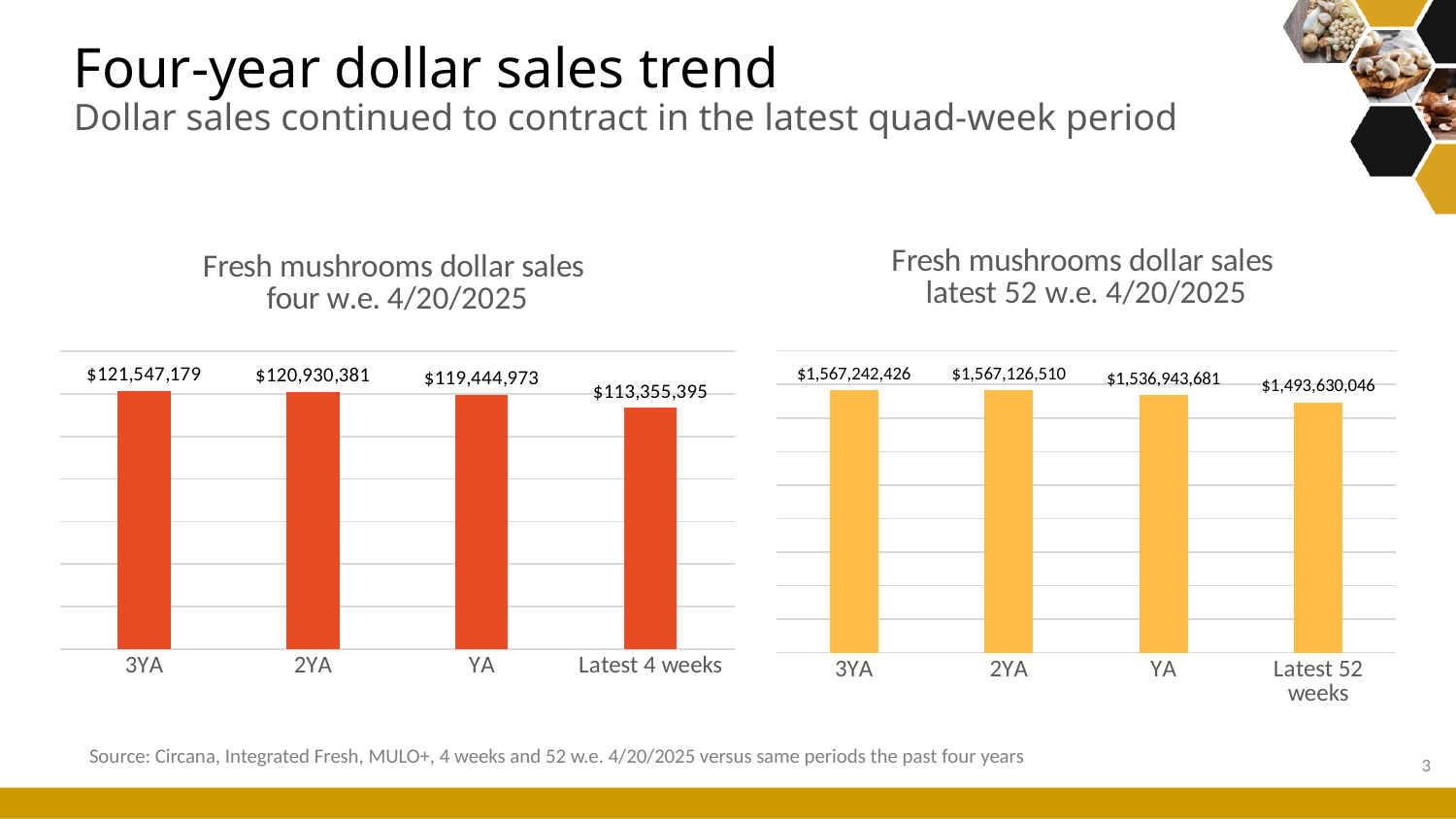
What kind of chart is the 'Fresh mushrooms dollar sales four w.e. 4/20/2025' chart? Bar chart In the 'Fresh mushrooms dollar sales latest 52 w.e. 4/20/2025' chart, what is the difference between the YA value and the Latest 52 weeks value? $43,313,635 In the 'Fresh mushrooms dollar sales four w.e. 4/20/2025' chart, what is the value for 3YA? $121,547,179 In the 'Fresh mushrooms dollar sales latest 52 w.e. 4/20/2025' chart, what is the value for Latest 52 weeks? $1,493,630,046 In the 'Fresh mushrooms dollar sales four w.e. 4/20/2025' chart, what is the difference between the 3YA value and the Latest 4 weeks value? $8,191,784 In the 'Fresh mushrooms dollar sales latest 52 w.e. 4/20/2025' chart, do the values rise or fall from 3YA to Latest 52 weeks? Fall In the 'Fresh mushrooms dollar sales latest 52 w.e. 4/20/2025' chart, what is the value for YA? $1,536,943,681 In the 'Fresh mushrooms dollar sales four w.e. 4/20/2025' chart, which is larger, the value for 2YA or the value for YA? 2YA In the 'Fresh mushrooms dollar sales four w.e. 4/20/2025' chart, which category has the highest value? 3YA In the 'Fresh mushrooms dollar sales latest 52 w.e. 4/20/2025' chart, which category has the lowest value? Latest 52 weeks In the 'Fresh mushrooms dollar sales four w.e. 4/20/2025' chart, what is the value for Latest 4 weeks? $113,355,395 How many categories are shown in the 'Fresh mushrooms dollar sales latest 52 w.e. 4/20/2025' chart? 4